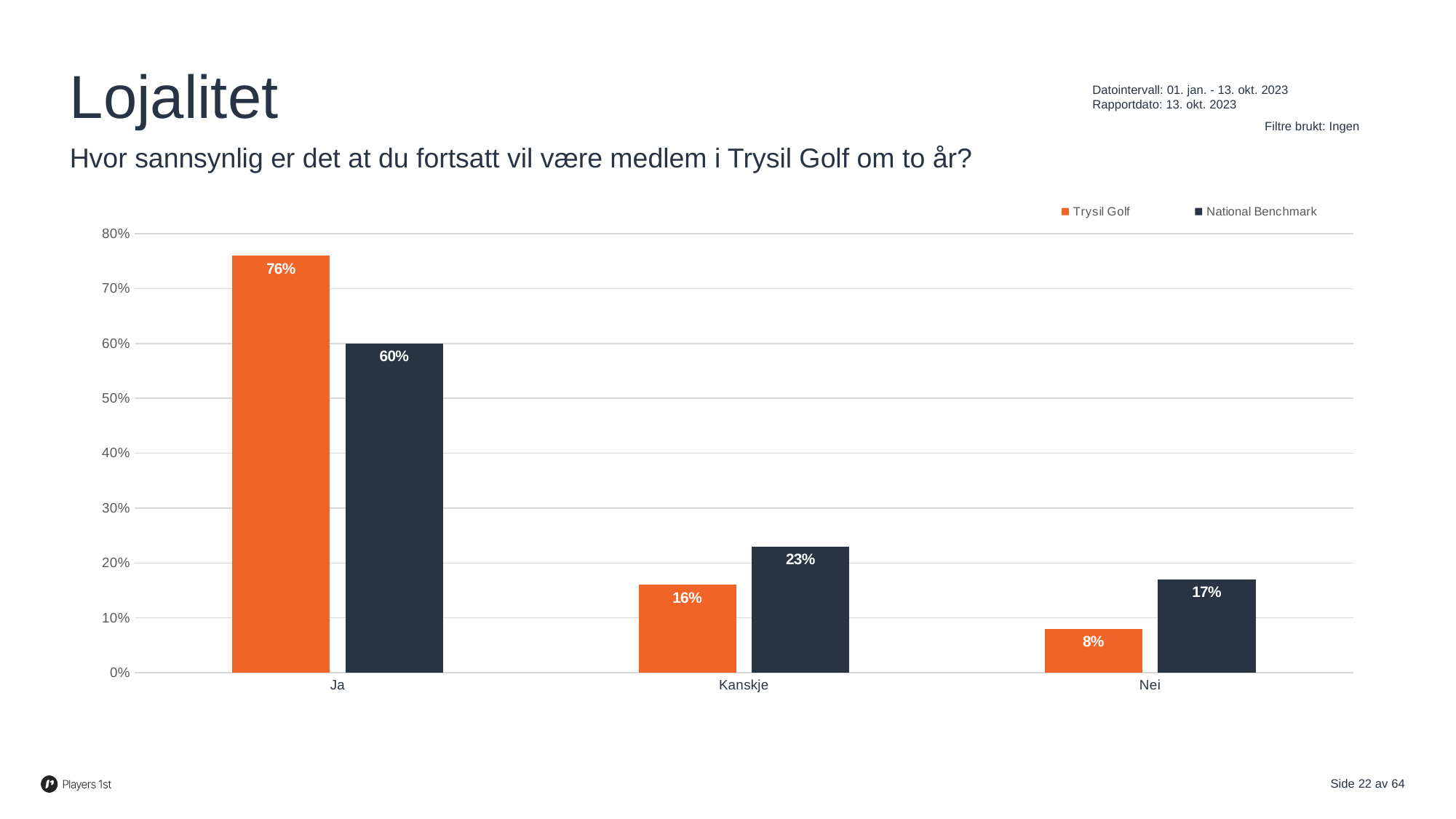
What is the value for Trysil Golf in the Nei category? 8% Which category has the highest Trysil Golf value? Ja Which colour represents Trysil Golf in the chart? orange Which category has the lowest National Benchmark value? Nei What is the difference between Trysil Golf and National Benchmark in the Ja category? 16% How many categories are shown on the x axis? 3 What kind of chart is shown on the slide? bar chart How many series does the legend list? 2 Is the National Benchmark value for Nei greater or less than 20%? less In the Kanskje category, which is larger: Trysil Golf or National Benchmark? National Benchmark What is the value for Trysil Golf in the Ja category? 76% What is the National Benchmark value for Kanskje? 23%